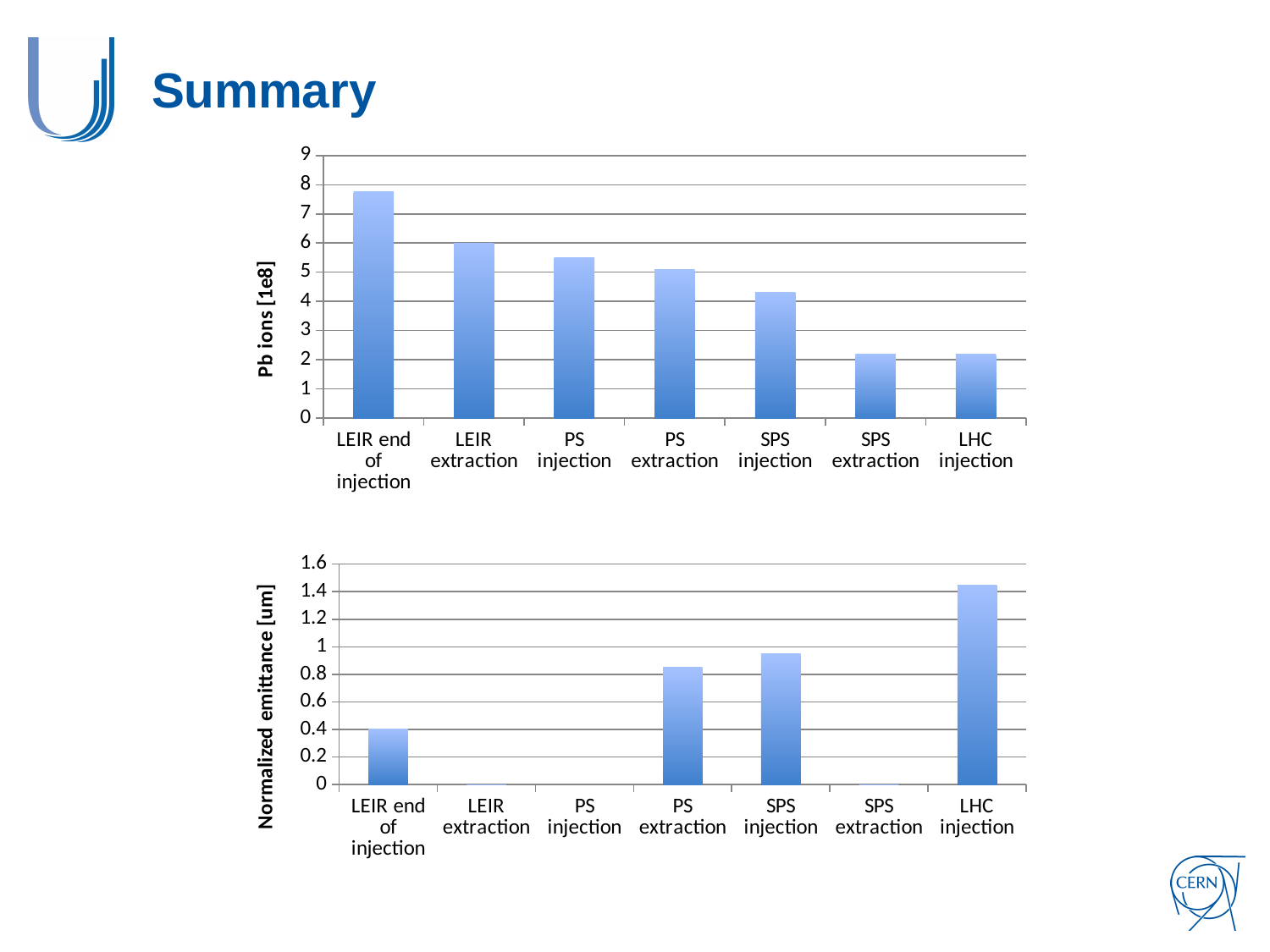
How many categories are shown on the x axis of the top chart? 7 In the top chart (Pb ions [1e8]), do the values generally rise or fall from left to right along the x axis? fall In the top chart (Pb ions [1e8]), is the value for SPS injection greater or less than 5? less In the top chart (Pb ions [1e8]), what is the value for LEIR extraction? 6 In the bottom chart (Normalized emittance [um]), is the value for LHC injection greater or less than 1.4? greater In the top chart (Pb ions [1e8]), which is larger, PS injection or SPS injection? PS injection What type of chart is the top chart on the slide? bar chart In the bottom chart (Normalized emittance [um]), which category has the highest value? LHC injection In the bottom chart (Normalized emittance [um]), what is the value for LEIR end of injection? 0.4 In the top chart (Pb ions [1e8]), is the value for LEIR end of injection greater or less than 7? greater What is the y-axis label of the bottom chart? Normalized emittance [um] In the top chart (Pb ions [1e8]), which category has the highest value? LEIR end of injection